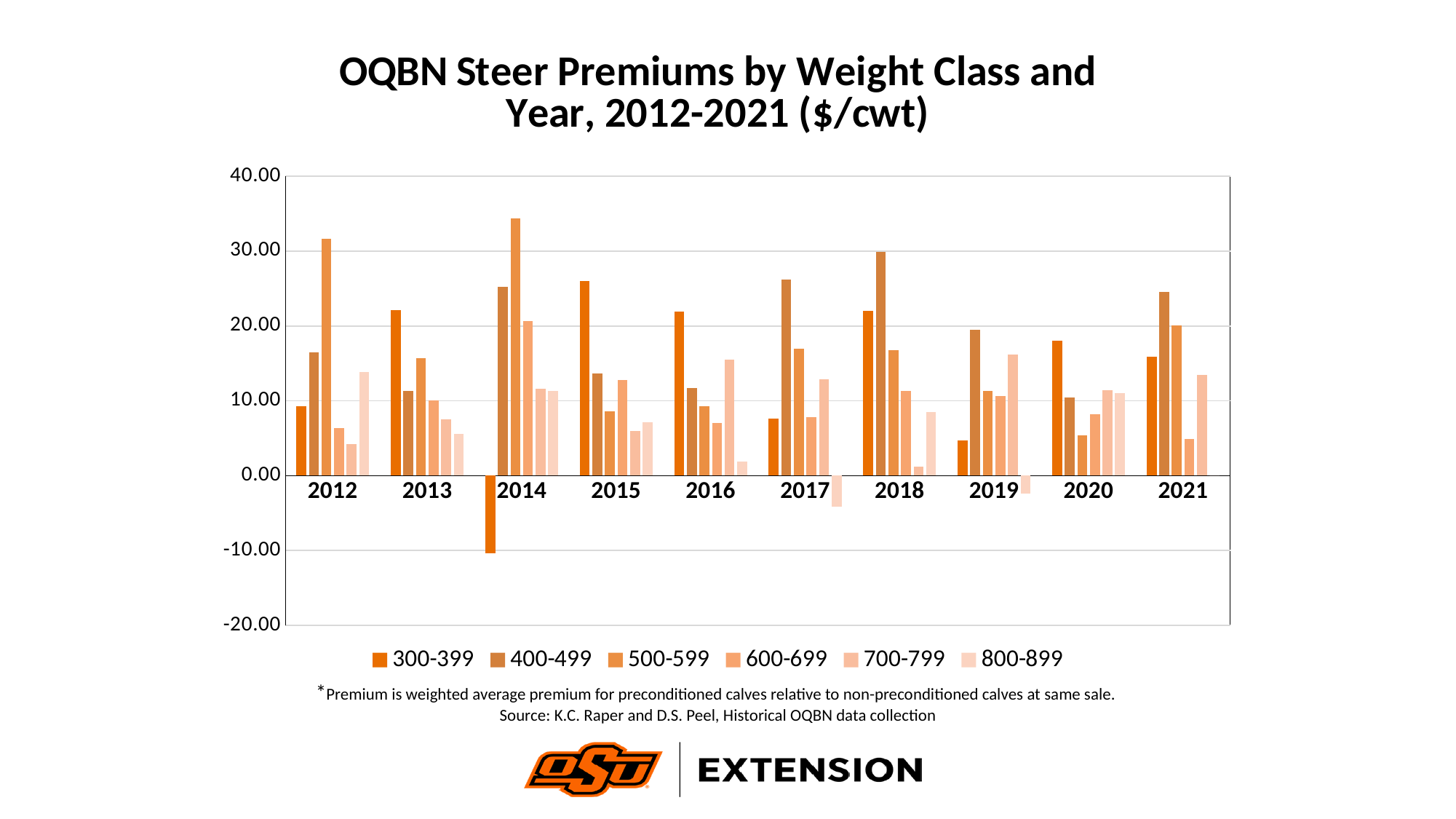
Is the value for the 500-599 weight class in 2014 greater or less than 30.00? greater In 2012, which is larger: the premium for 300-399 or for 500-599? 500-599 Is the value for the 300-399 weight class in 2014 greater or less than 0.00? less Which weight class has the highest premium in 2020? 300-399 In which year is the 500-599 weight class premium the highest? 2014 How many years are shown along the x axis? 10 Is the value for the 800-899 weight class in 2017 greater or less than 0.00? less What is the title of the chart? OQBN Steer Premiums by Weight Class and Year, 2012-2021 ($/cwt) How many weight-class series does the legend list? 6 What kind of chart is shown on the slide? bar chart Which weight class has the lowest premium in 2014? 300-399